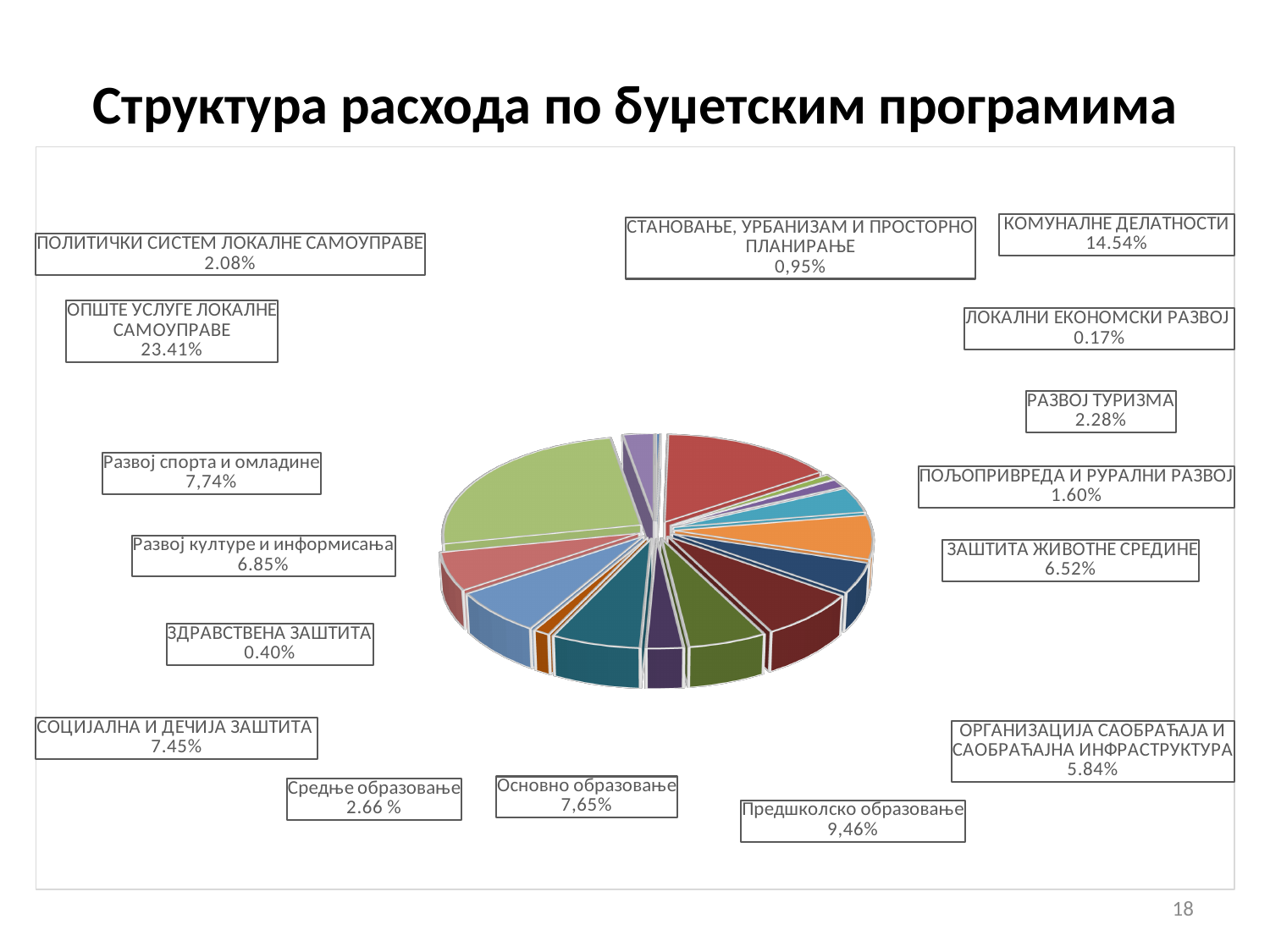
What share is shown for КОМУНАЛНЕ ДЕЛАТНОСТИ? 14.54% What share is shown for Предшколско образовање? 9,46% Which budget programme has the smallest share of expenditure? ЛОКАЛНИ ЕКОНОМСКИ РАЗВОЈ What share is shown for ЛОКАЛНИ ЕКОНОМСКИ РАЗВОЈ? 0.17% What share is shown for ОПШТЕ УСЛУГЕ ЛОКАЛНЕ САМОУПРАВЕ? 23.41% What is the title of the chart on the slide? Структура расхода по буџетским програмима Which budget programme has the largest share of expenditure? ОПШТЕ УСЛУГЕ ЛОКАЛНЕ САМОУПРАВЕ What share is shown for СТАНОВАЊЕ, УРБАНИЗАМ И ПРОСТОРНО ПЛАНИРАЊЕ? 0,95% Which has the larger share, Предшколско образовање or Основно образовање? Предшколско образовање What kind of chart is shown on the slide? Pie chart How many budget programmes are labelled on the pie chart? 16 What is the difference in percentage points between ОПШТЕ УСЛУГЕ ЛОКАЛНЕ САМОУПРАВЕ and КОМУНАЛНЕ ДЕЛАТНОСТИ? 8.87%